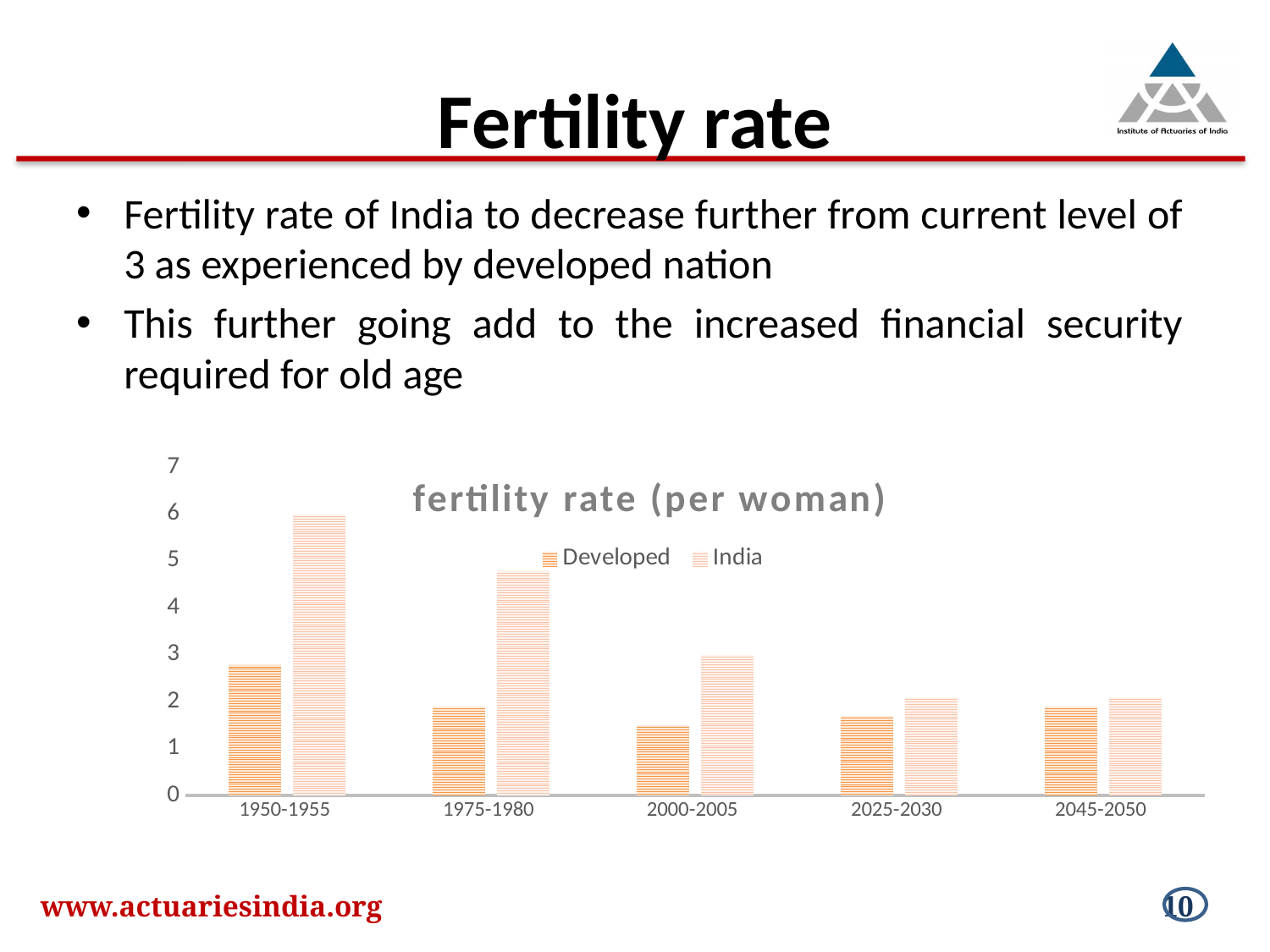
In 1950-1955, which series has the larger fertility rate, Developed or India? India Is the fertility rate for India in 1950-1955 greater or less than 5? greater Which period has the highest fertility rate for India? 1950-1955 What kind of chart is shown on the slide? bar chart What is the title of the chart? fertility rate (per woman) Is the fertility rate for Developed in 1950-1955 greater or less than 3? less How many series does the chart legend list? 2 How many time periods are shown on the x axis of the chart? 5 Is the fertility rate for India in 1975-1980 greater or less than 4? greater Does the fertility rate for India rise or fall from 1950-1955 to 2045-2050? fall Which period has the highest fertility rate for Developed? 1950-1955 Which period has the lowest fertility rate for Developed? 2000-2005